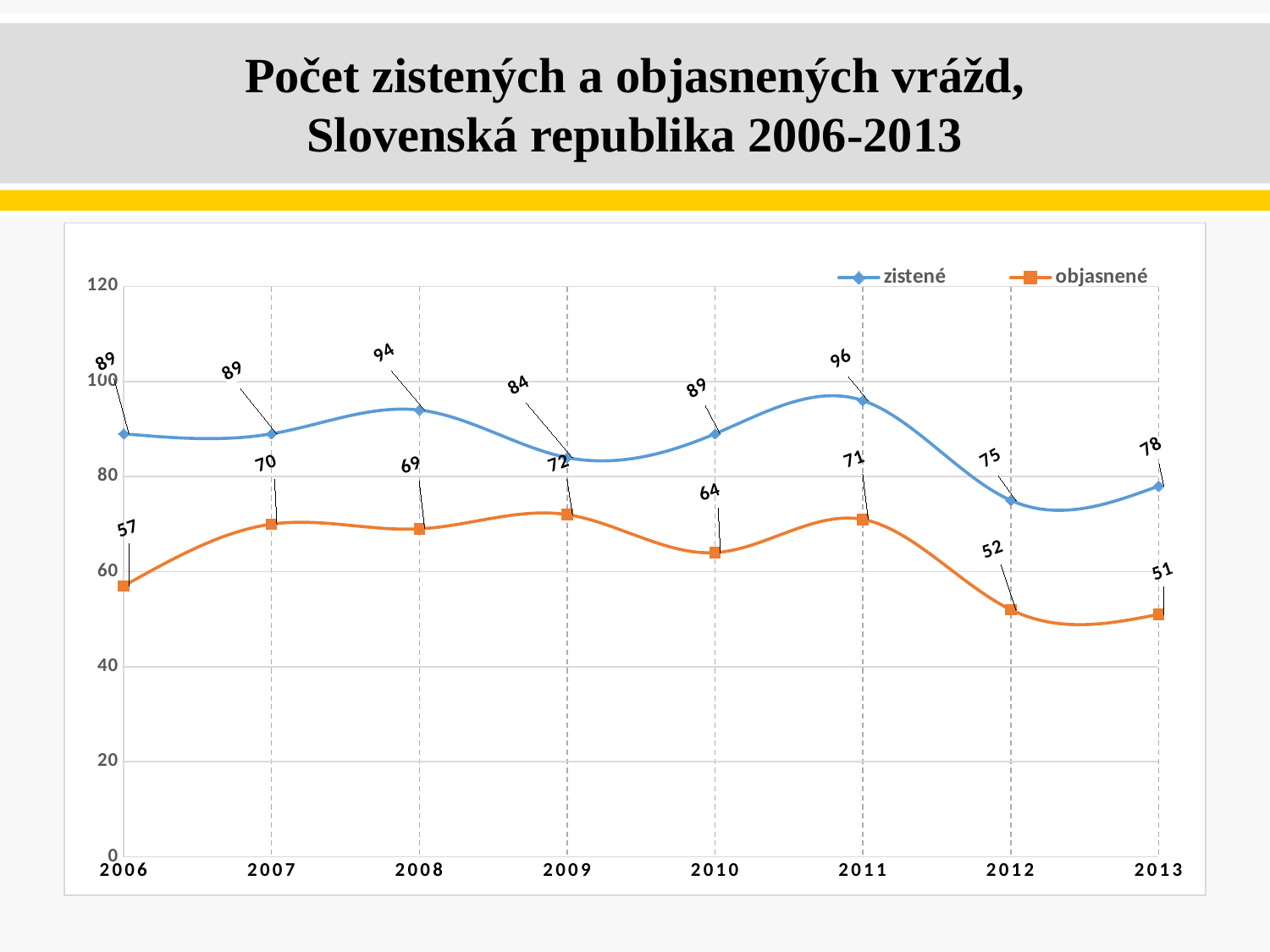
What is the value of the objasnené series in 2006? 57 Which colour is used for the objasnené series? orange What is the value of the objasnené series in 2013? 51 Does the zistené series rise or fall from 2011 to 2012? fall In which year is the zistené series highest? 2011 Which is larger: the objasnené value in 2009 or in 2010? 2009 What is the difference between zistené and objasnené in 2008? 25 What is the value of the zistené series in 2011? 96 How many series does the legend list? 2 In which year is the objasnené series lowest? 2013 How many years are shown on the x axis? 8 What kind of chart is shown on the slide? line chart